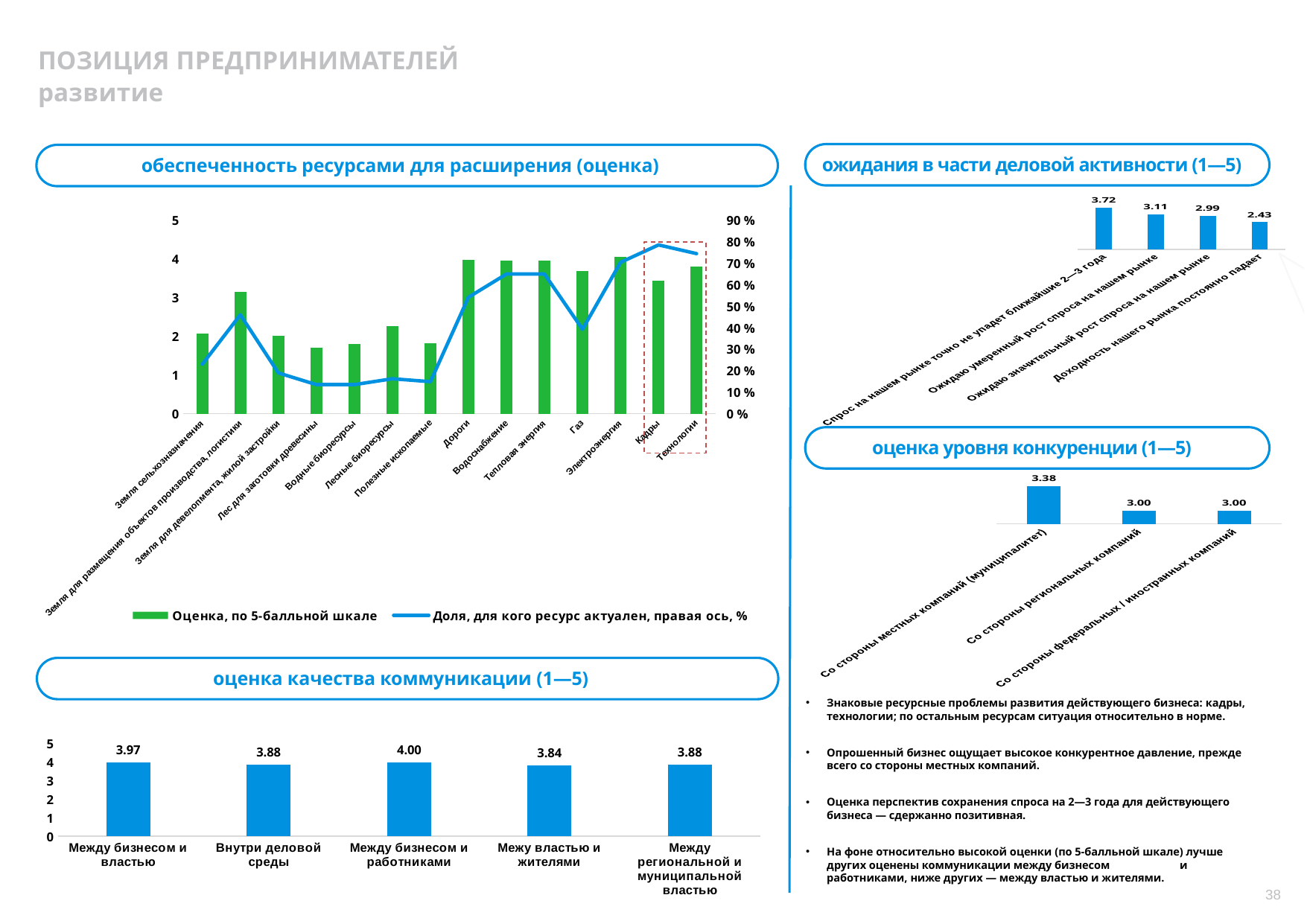
How many categories are shown in the chart 'оценка качества коммуникации (1—5)'? 5 In the chart 'ожидания в части деловой активности (1—5)', what is the value for 'Доходность нашего рынка постоянно падает'? 2.43 In the chart 'ожидания в части деловой активности (1—5)', do the values rise or fall from left to right? fall In the chart 'обеспеченность ресурсами для расширения (оценка)', is the bar value for 'Дороги' greater or less than 3? greater In the chart 'оценка качества коммуникации (1—5)', which category has the lowest value? Межу властью и жителями In the chart 'оценка уровня конкуренции (1—5)', what is the difference between 'Со стороны местных компаний (муниципалитет)' and 'Со стороны региональных компаний'? 0.38 In the chart 'оценка качества коммуникации (1—5)', what is the value for 'Между бизнесом и работниками'? 4.00 How many series does the legend list in the chart 'обеспеченность ресурсами для расширения (оценка)'? 2 In the chart 'оценка качества коммуникации (1—5)', what is the difference between 'Между бизнесом и работниками' and 'Межу властью и жителями'? 0.16 What kind of chart is 'оценка уровня конкуренции (1—5)'? bar chart In the chart 'оценка уровня конкуренции (1—5)', what is the value for 'Со стороны местных компаний (муниципалитет)'? 3.38 In the chart 'ожидания в части деловой активности (1—5)', which category has the highest value? Спрос на нашем рынке точно не упадет ближайшие 2—3 года